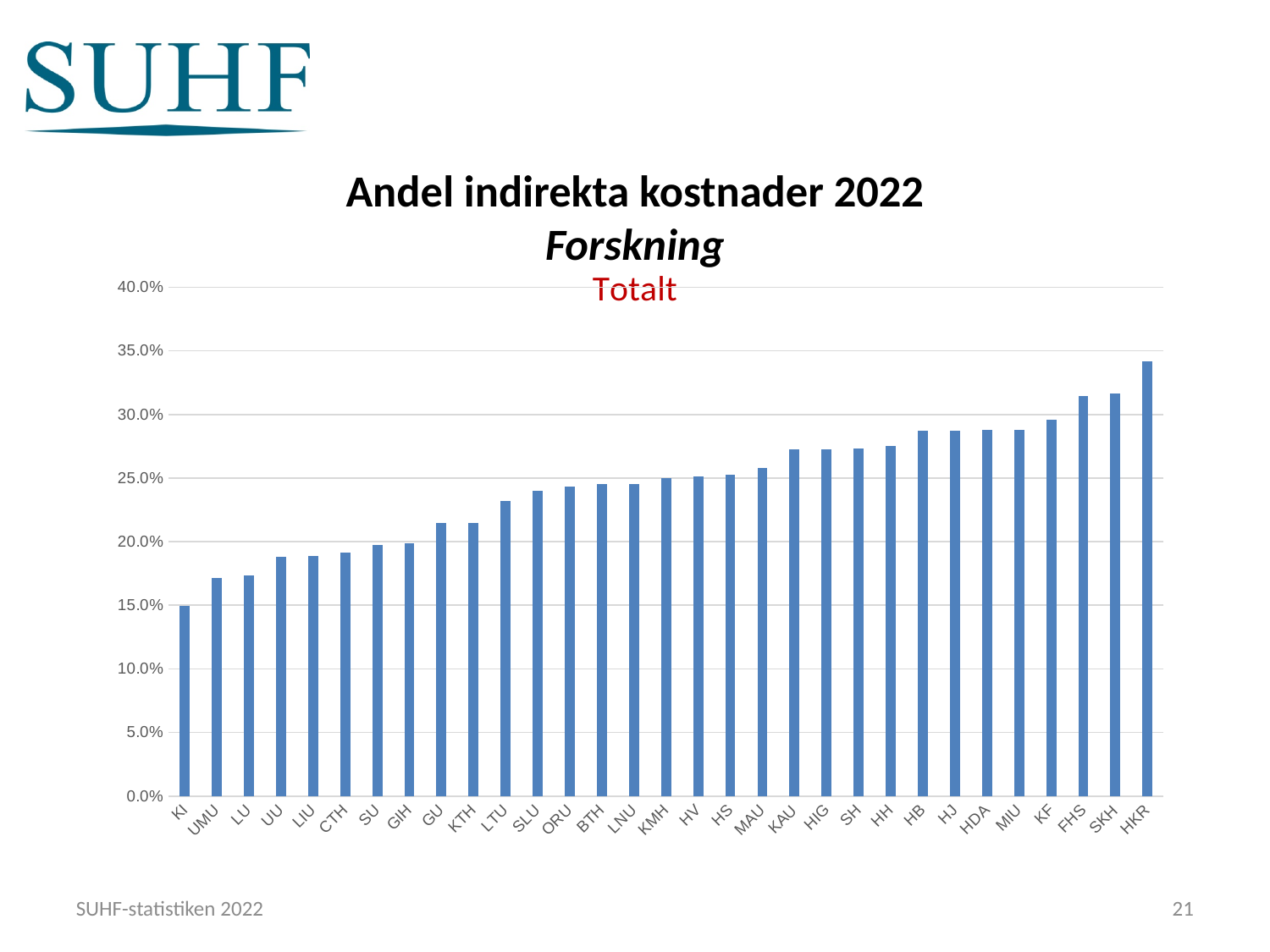
Is the value for GU greater or less than 20.0%? greater Do the values generally rise or fall from left to right along the x axis? rise What kind of chart is shown on the slide? bar chart Which category has the lowest value in the chart? KI Which has the larger value, UMU or HB? HB What is the main title of the chart? Andel indirekta kostnader 2022 Is the value for HKR greater or less than 30.0%? greater Is the value for LU greater or less than 20.0%? less How many categories are shown along the x axis of the chart? 31 Which category has the highest value in the chart? HKR